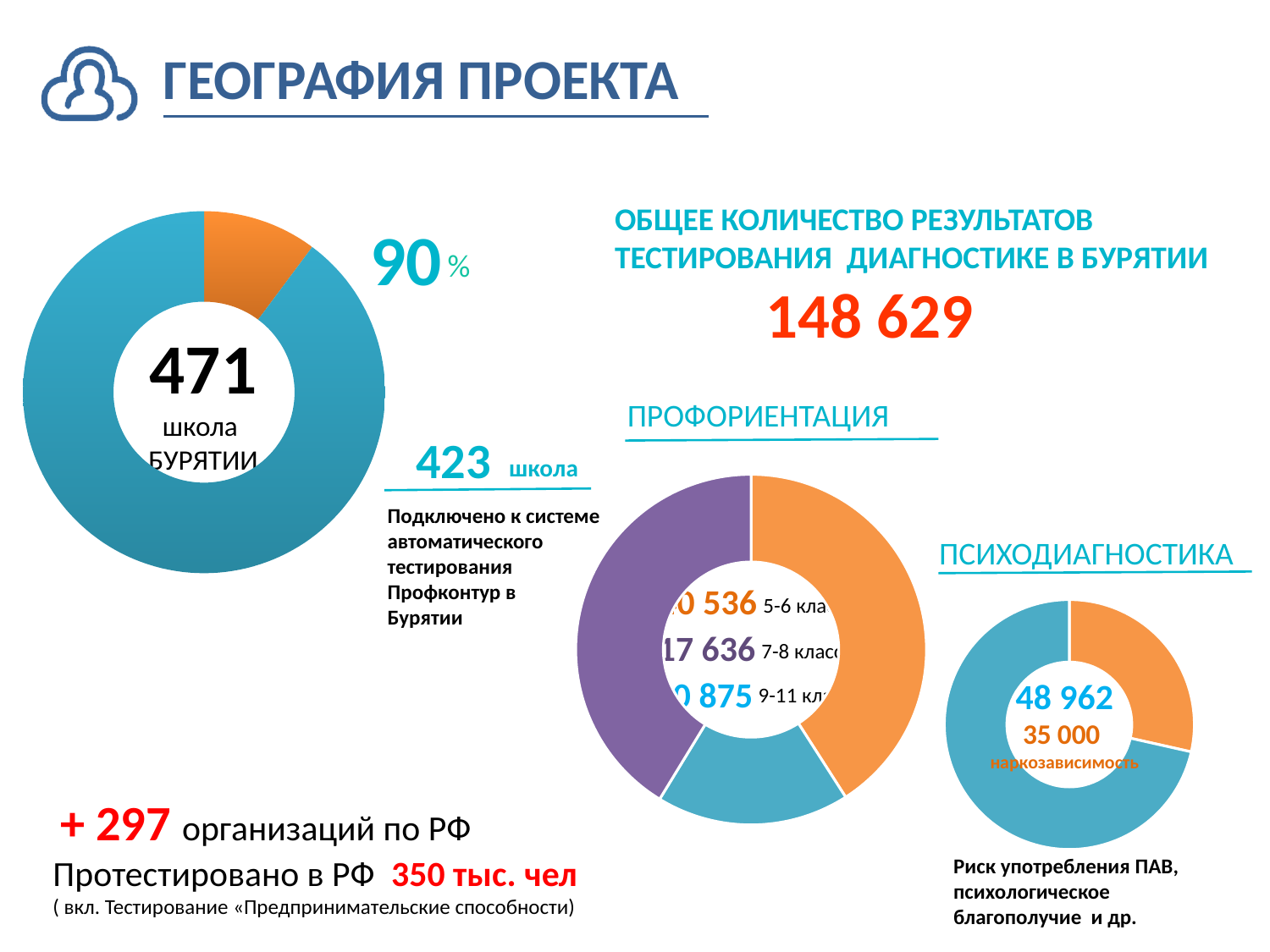
How many slices does the left donut chart have? 2 In the ПРОФОРИЕНТАЦИЯ chart, which colour slice is the smallest? blue In the left chart, which slice is larger, the blue one or the orange one? blue In the ПСИХОДИАГНОСТИКА chart, what total number is printed in the centre? 48 962 In the left chart, what percentage is printed next to the blue slice? 90% How many slices does the ПСИХОДИАГНОСТИКА donut chart have? 2 How many slices does the ПРОФОРИЕНТАЦИЯ donut chart have? 3 In the ПСИХОДИАГНОСТИКА chart, what value is printed for наркозависимость? 35 000 What kind of chart is the left chart showing 471 школа Бурятии? pie chart (donut) In the left chart, what number is printed in the centre of the donut? 471 In the ПСИХОДИАГНОСТИКА chart, which slice is larger, the blue one or the orange one? blue